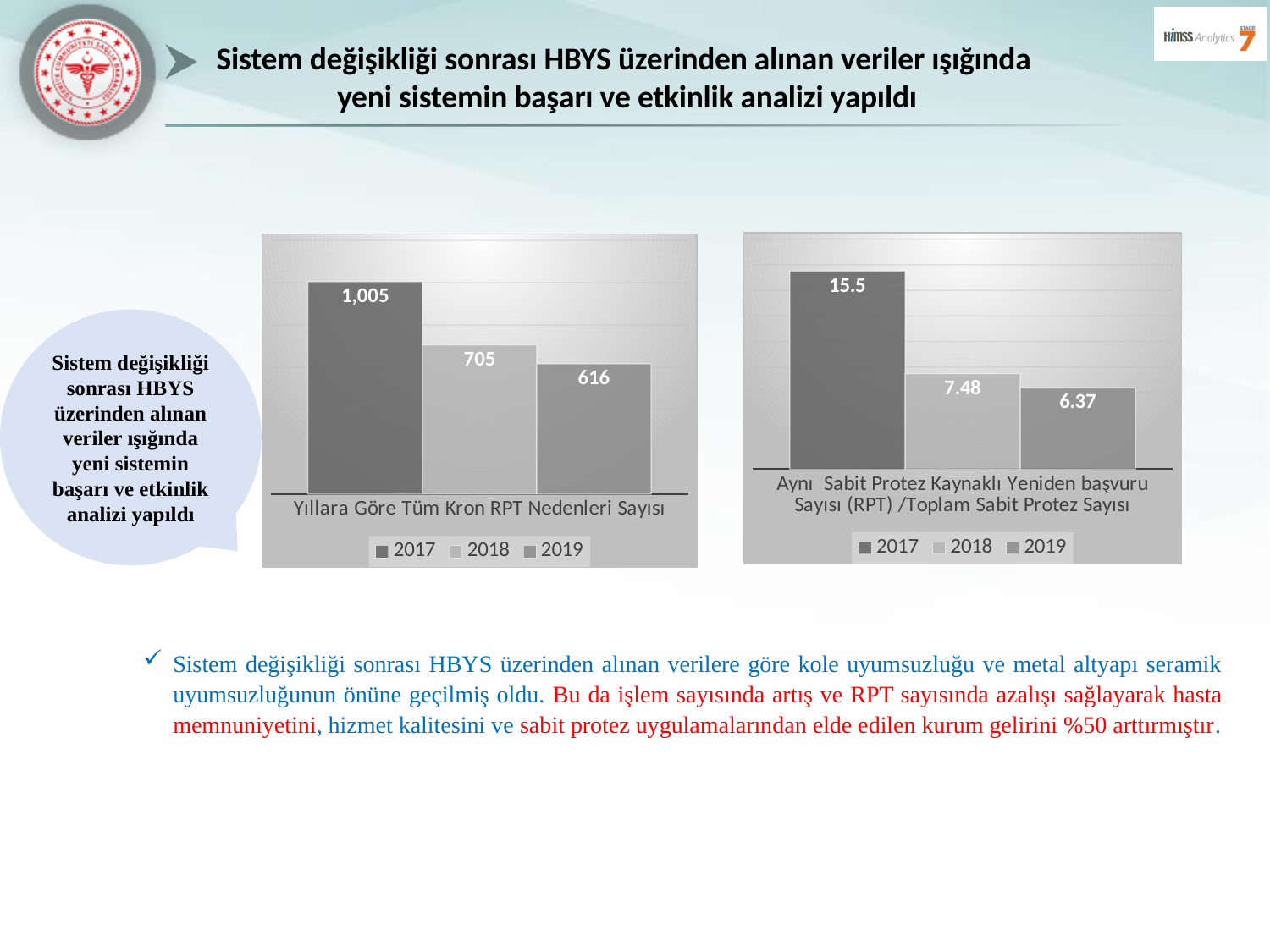
In the left chart (Yıllara Göre Tüm Kron RPT Nedenleri Sayısı), what is the value for 2019? 616 How many series does the legend of the right chart (Aynı Sabit Protez Kaynaklı Yeniden başvuru Sayısı (RPT) /Toplam Sabit Protez Sayısı) list? 3 What kind of chart is the left chart (Yıllara Göre Tüm Kron RPT Nedenleri Sayısı)? Bar chart In the left chart (Yıllara Göre Tüm Kron RPT Nedenleri Sayısı), what is the difference between the 2017 and 2018 values? 300 In the left chart (Yıllara Göre Tüm Kron RPT Nedenleri Sayısı), which is larger, the value for 2018 or the value for 2019? 2018 In the right chart (Aynı Sabit Protez Kaynaklı Yeniden başvuru Sayısı (RPT) /Toplam Sabit Protez Sayısı), what is the difference between the 2018 and 2019 values? 1.11 In the right chart (Aynı Sabit Protez Kaynaklı Yeniden başvuru Sayısı (RPT) /Toplam Sabit Protez Sayısı), what is the value for 2018? 7.48 What years are listed in the legend of the left chart (Yıllara Göre Tüm Kron RPT Nedenleri Sayısı)? 2017, 2018, 2019 In the left chart (Yıllara Göre Tüm Kron RPT Nedenleri Sayısı), what is the value for 2017? 1,005 In the left chart (Yıllara Göre Tüm Kron RPT Nedenleri Sayısı), which year has the lowest value? 2019 In the right chart (Aynı Sabit Protez Kaynaklı Yeniden başvuru Sayısı (RPT) /Toplam Sabit Protez Sayısı), which year has the highest value? 2017 In the right chart (Aynı Sabit Protez Kaynaklı Yeniden başvuru Sayısı (RPT) /Toplam Sabit Protez Sayısı), do the values rise or fall from 2017 to 2019? Fall